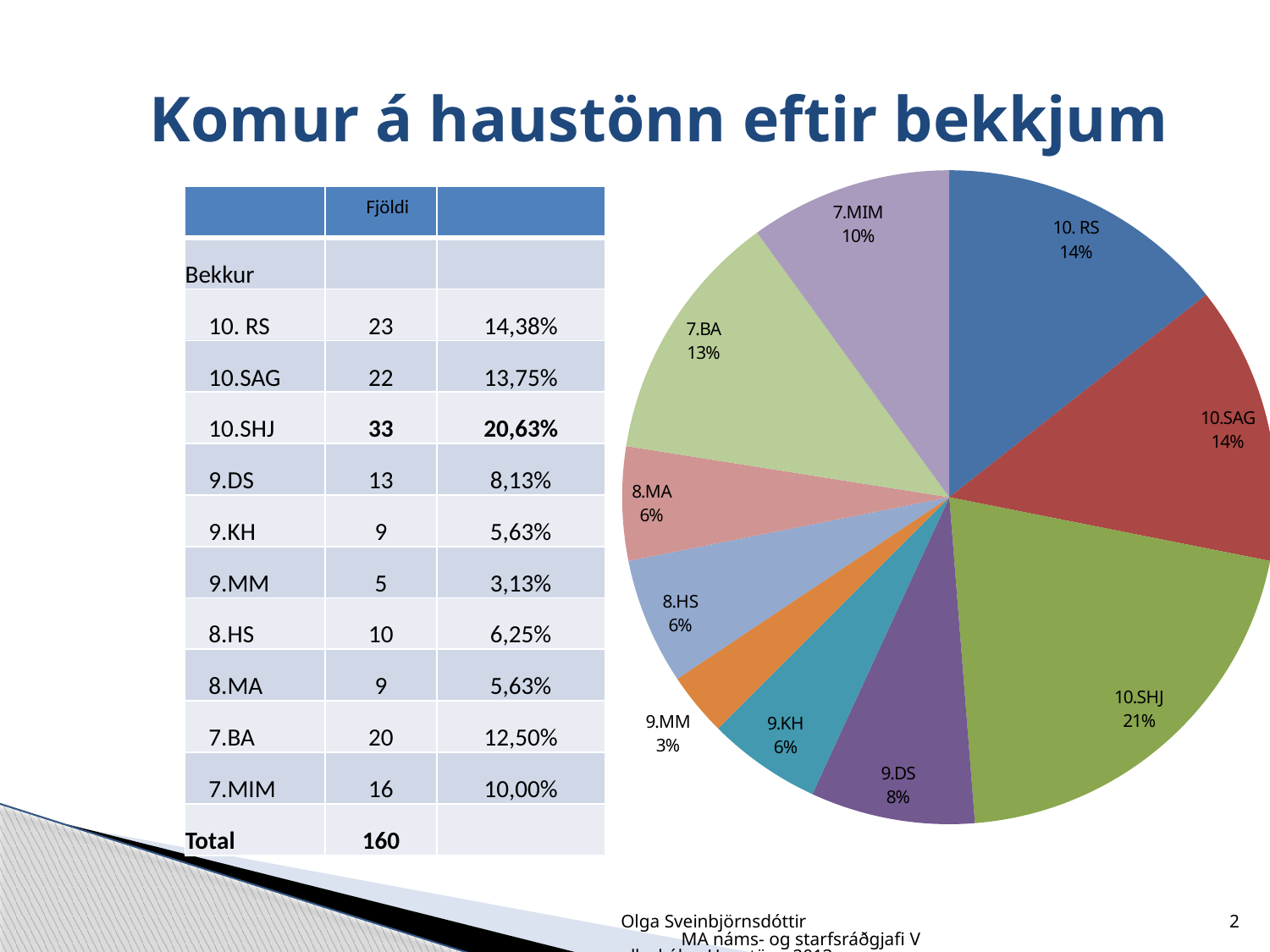
What share of the pie chart does 9.DS have? 8% What is the difference in percentage points between the 10.SHJ slice and the 9.MM slice in the pie chart? 18 What is the title of the slide containing the pie chart? Komur á haustönn eftir bekkjum How many slices does the pie chart have? 10 What share of the pie chart does 7.MIM have? 10% What share of the pie chart does 10.SHJ have? 21% Which slice of the pie chart is the largest? 10.SHJ What kind of chart is shown on the slide? pie chart Which slice of the pie chart is the smallest? 9.MM Which is larger in the pie chart, 7.BA or 9.DS? 7.BA